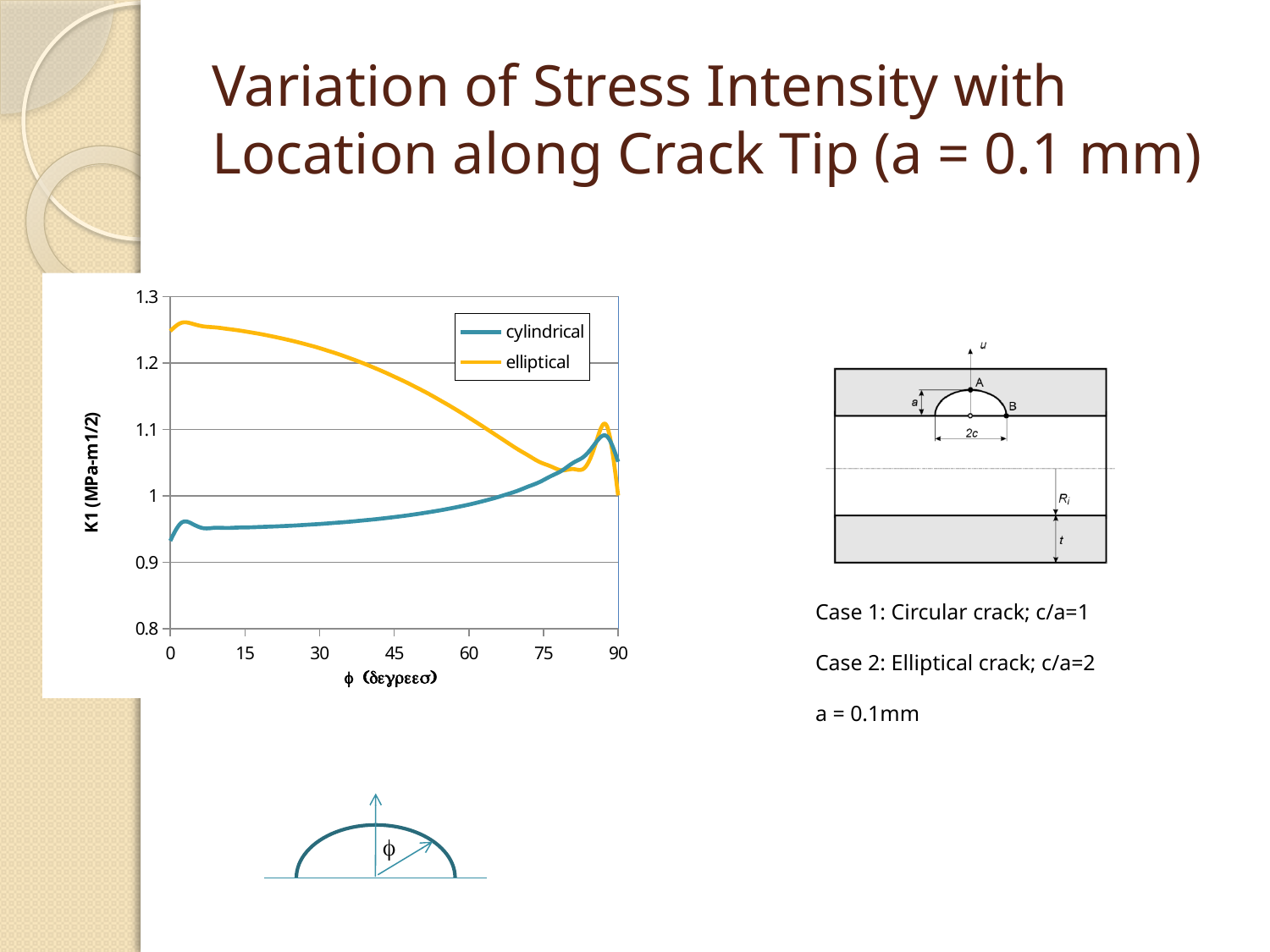
Does the elliptical series rise or fall as φ increases from 0 to 75? fall Is the value of the elliptical series at φ = 45 greater or less than 1.1? greater Does the cylindrical series rise or fall as φ increases from 15 to 75? rise What are the two series named in the chart's legend? cylindrical and elliptical Is the value of the elliptical series at φ = 0 greater or less than 1.2? greater Is the value of the elliptical series at φ = 75 greater or less than 1.1? less What is the label of the chart's vertical axis? K1 (MPa-m1/2) At φ = 15, which series has the higher K1 value, cylindrical or elliptical? elliptical How many series does the chart's legend list? 2 What kind of chart is shown on the slide? line chart